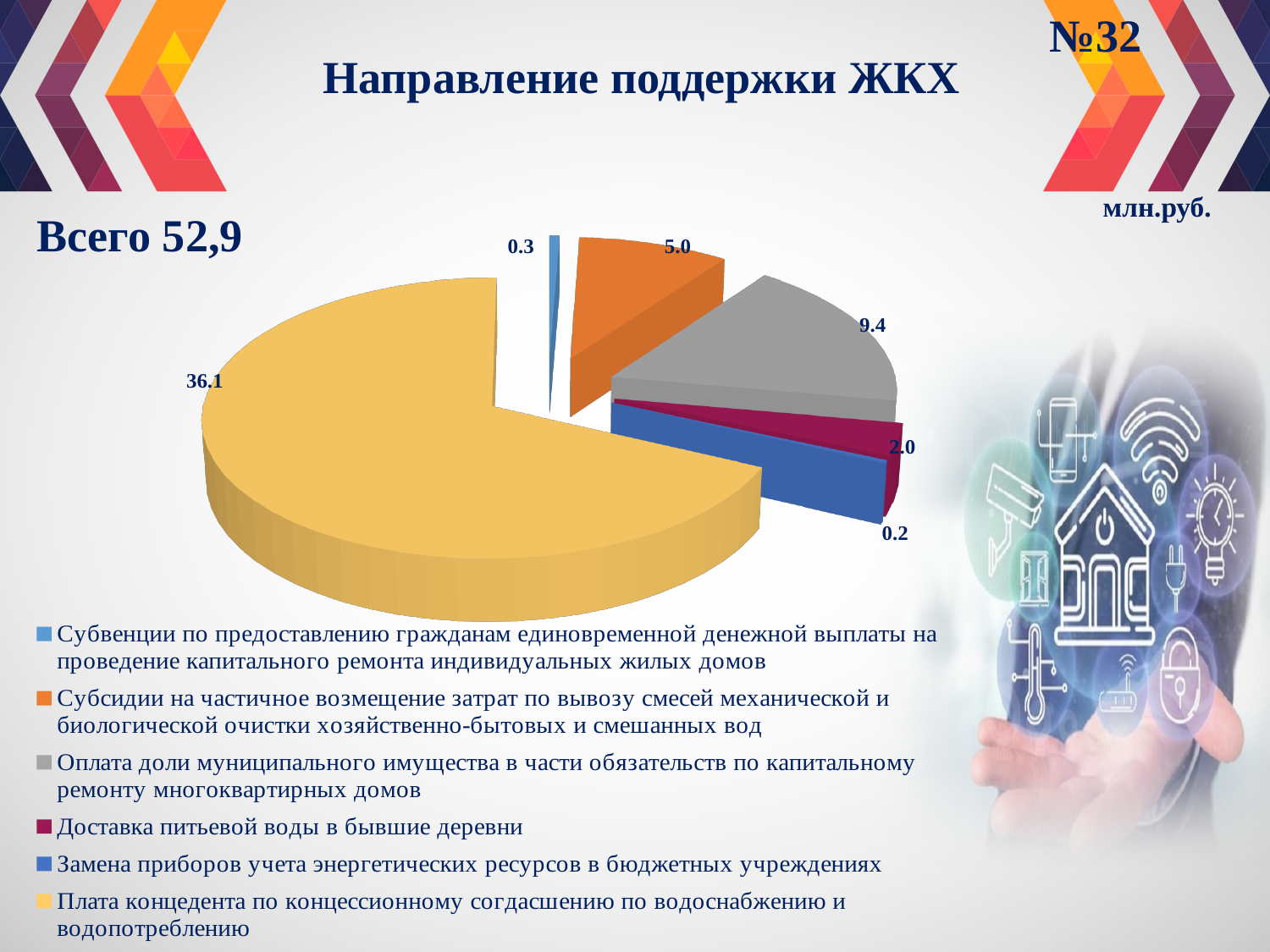
Which is larger: the slice for "Субсидии на частичное возмещение затрат..." or the slice for "Доставка питьевой воды в бывшие деревни"? Субсидии на частичное возмещение затрат по вывозу смесей механической и биологической очистки хозяйственно-бытовых и смешанных вод Which category has the largest slice in the pie chart? Плата концедента по концессионному согдасшению по водоснабжению и водопотреблению What is the title of the chart on the slide? Направление поддержки ЖКХ What is the value of the slice for "Доставка питьевой воды в бывшие деревни"? 2.0 What is the value of the slice for "Замена приборов учета энергетических ресурсов в бюджетных учреждениях"? 0.2 What is the value of the slice for "Субсидии на частичное возмещение затрат по вывозу смесей механической и биологической очистки хозяйственно-бытовых и смешанных вод"? 5.0 What is the difference between the largest slice (36.1) and the slice for "Оплата доли муниципального имущества..." (9.4)? 26.7 How many categories does the legend of the pie chart list? 6 What is the value of the slice for "Оплата доли муниципального имущества в части обязательств по капитальному ремонту многоквартирных домов"? 9.4 What is the value of the slice for "Плата концедента по концессионному согдашению по водоснабжению и водопотреблению"? 36.1 What type of chart is shown on the slide? Pie chart Which category has the smallest slice in the pie chart? Замена приборов учета энергетических ресурсов в бюджетных учреждениях